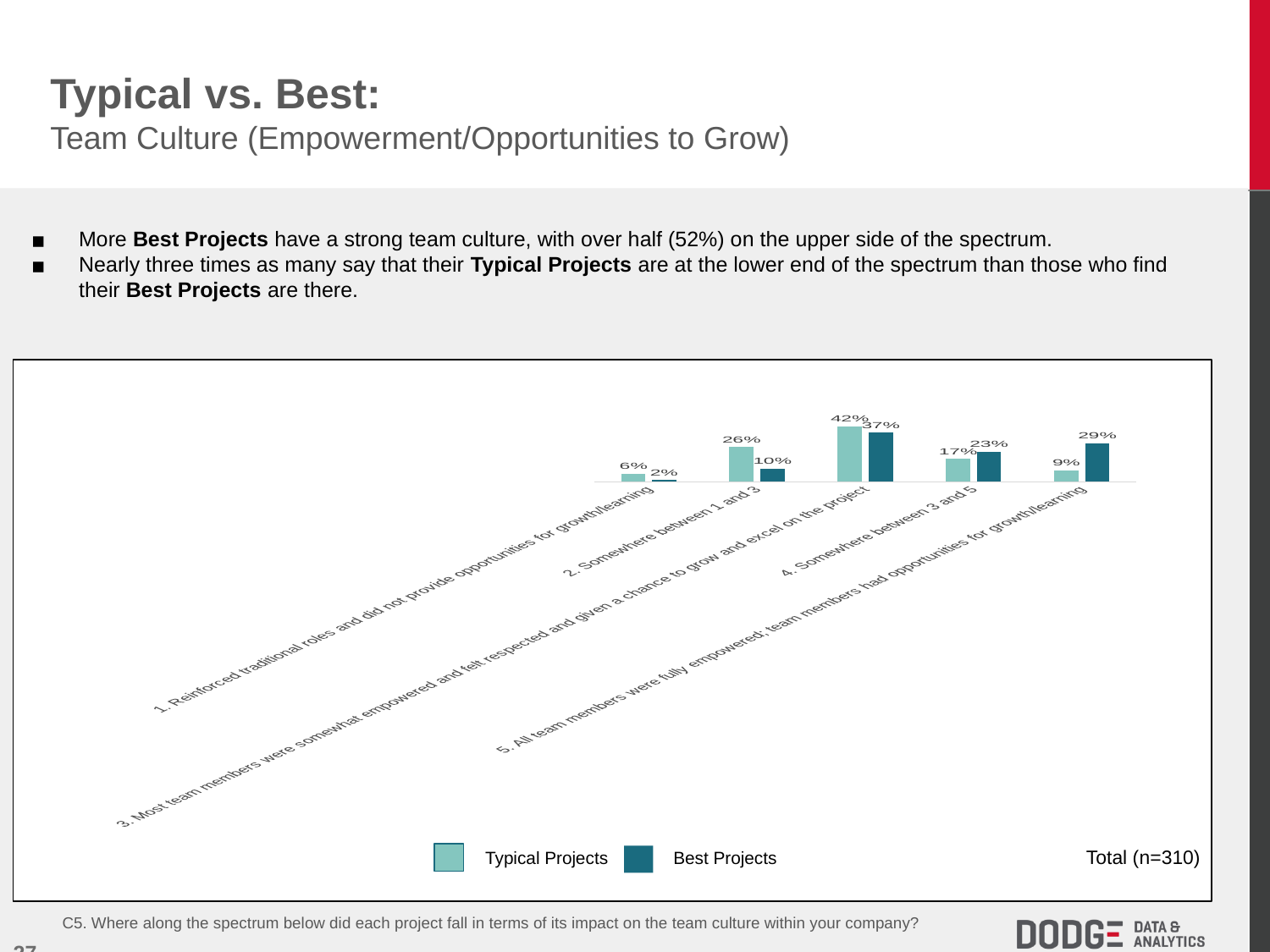
For category 4 (Somewhere between 3 and 5), which series has the larger value, Typical Projects or Best Projects? Best Projects How many series does the legend list? 2 What is the Typical Projects value for category 3 (Most team members were somewhat empowered and felt respected and given a chance to grow and excel on the project)? 42% What is the Best Projects value for category 1 (Reinforced traditional roles and did not provide opportunities for growth/learning)? 2% What is the difference between the Best Projects and Typical Projects values for category 5 (All team members were fully empowered, team members had opportunities for growth/learning)? 20% What sample size is noted in the bottom right of the chart? Total (n=310) Which category has the lowest Best Projects value? 1. Reinforced traditional roles and did not provide opportunities for growth/learning What kind of chart is shown on the slide? bar chart What is the difference between the Typical Projects and Best Projects values for category 2 (Somewhere between 1 and 3)? 16% How many categories are shown along the x axis? 5 Which category has the highest Typical Projects value? 3. Most team members were somewhat empowered and felt respected and given a chance to grow and excel on the project What is the Best Projects value for category 5 (All team members were fully empowered, team members had opportunities for growth/learning)? 29%